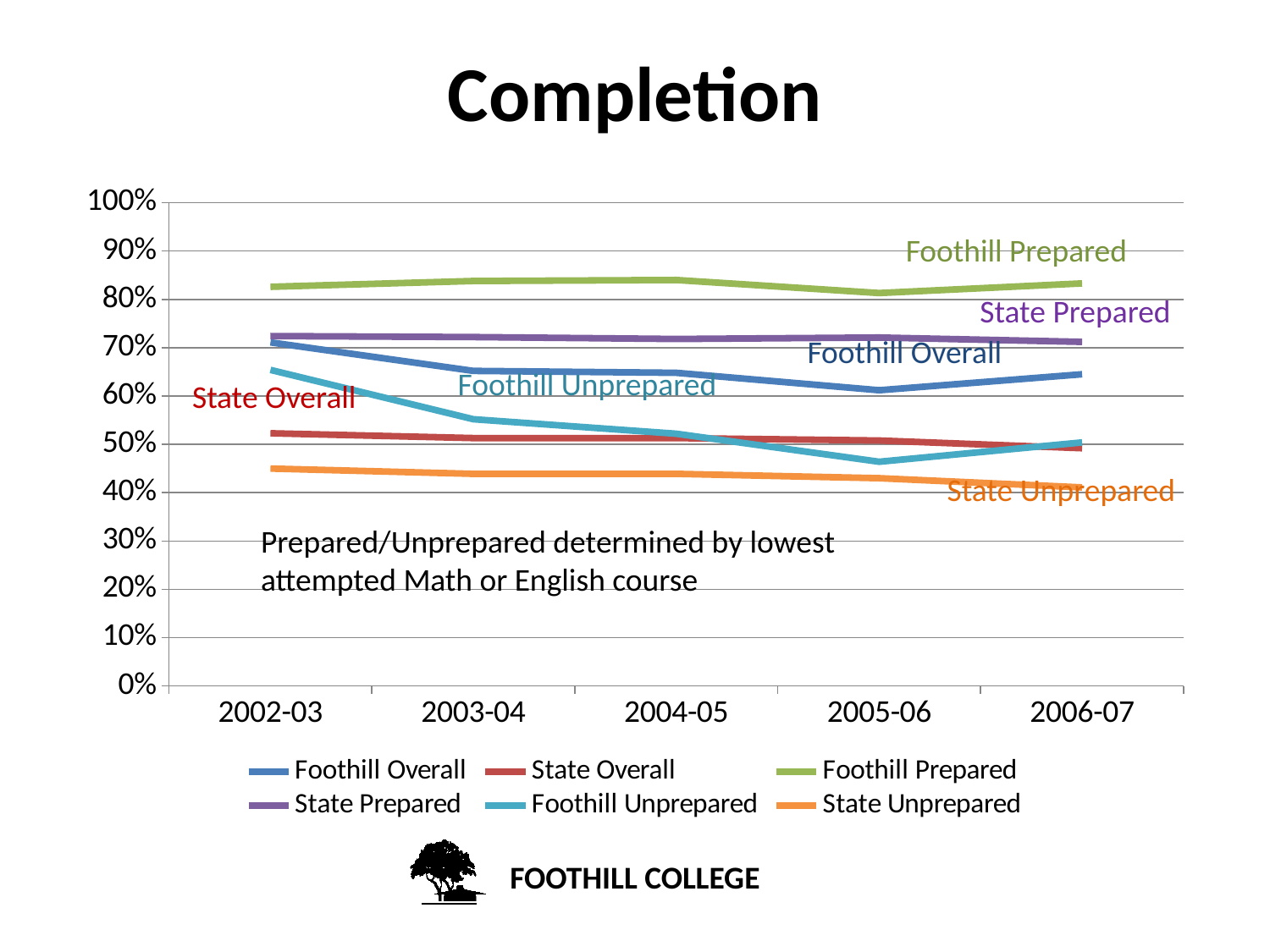
Does the Foothill Unprepared line rise or fall from 2002-03 to 2005-06? fall Which series has the highest value in 2002-03? Foothill Prepared What kind of chart is shown on the slide? line chart Is the value for Foothill Unprepared in 2005-06 greater or less than 50%? less How many academic years are shown on the x axis? 5 Is the value for Foothill Overall in 2002-03 greater or less than 60%? greater Is the value for Foothill Prepared in 2005-06 greater or less than 90%? less In 2002-03, which is larger: Foothill Unprepared or State Overall? Foothill Unprepared How many series does the legend list? 6 What is the title of the chart? Completion Which series has the lowest value in 2006-07? State Unprepared